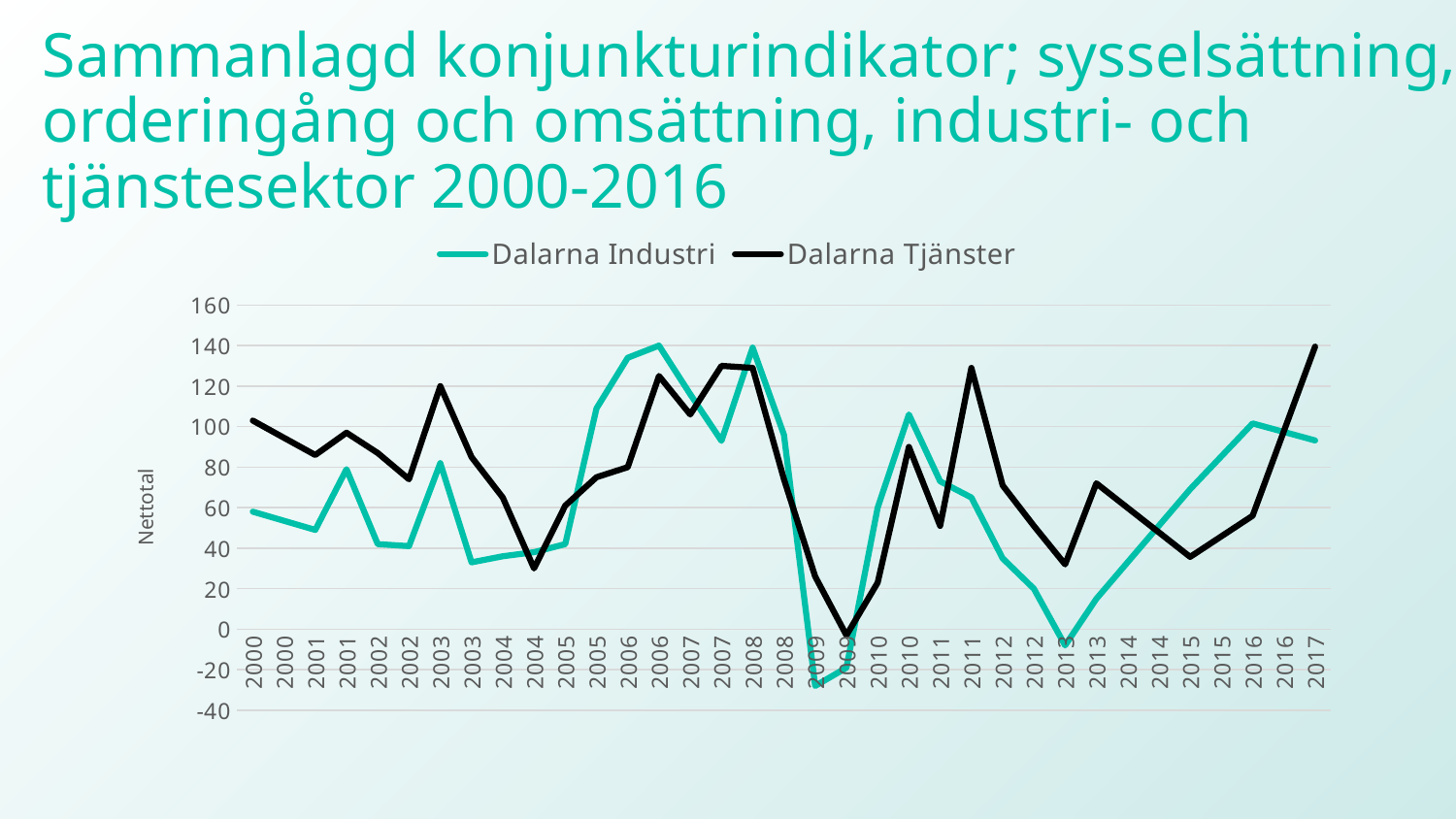
Does the Dalarna Tjänster line rise or fall from the second 2015 point to 2017? Rise Is the value for Dalarna Industri at the first 2009 point greater or less than 0? less How many series does the legend list? 2 What is the label on the vertical axis? Nettotal Is the value for Dalarna Industri at the second 2006 point greater or less than 120? greater What kind of chart is shown on the slide? Line chart What are the two series named in the legend? Dalarna Industri and Dalarna Tjänster At the second 2003 point, which series has the higher value, Dalarna Industri or Dalarna Tjänster? Dalarna Tjänster At 2017, which series has the higher value, Dalarna Industri or Dalarna Tjänster? Dalarna Tjänster Is the value for Dalarna Tjänster at the second 2004 point greater or less than 40? less